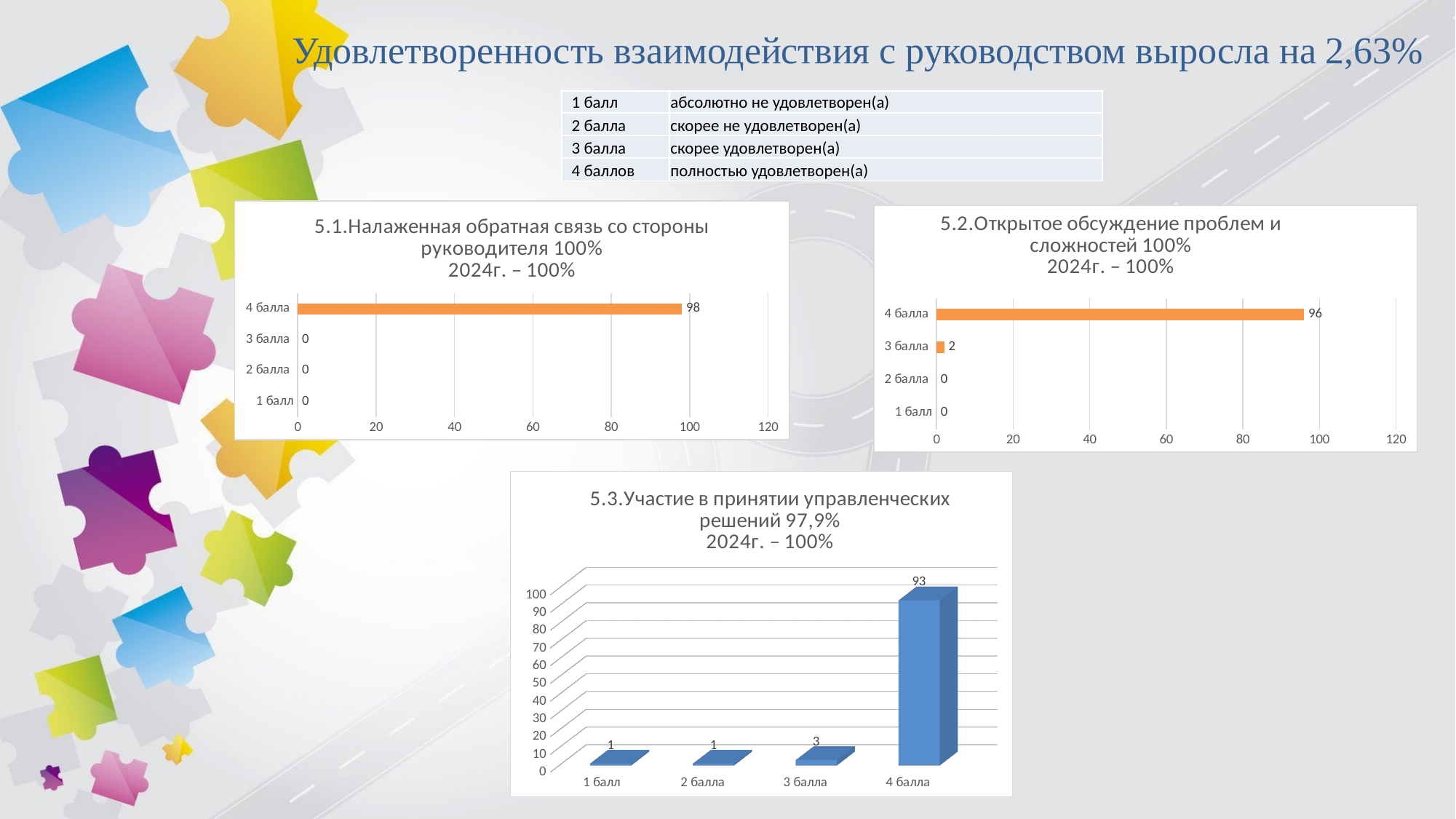
In the chart titled "5.3.Участие в принятии управленческих решений 97,9%", do the values rise or fall from 1 балл to 4 балла? rise Which chart has a value of 96 for 4 балла: the chart on the left, the chart on the right, or the chart at the bottom? The chart on the right (5.2.Открытое обсуждение проблем и сложностей 100%) In the chart titled "5.3.Участие в принятии управленческих решений 97,9%", what is the value for 3 балла? 3 In the chart titled "5.2.Открытое обсуждение проблем и сложностей 100%", what is the difference between the values for 4 балла and 3 балла? 94 In the chart titled "5.1.Налаженная обратная связь со стороны руководителя 100%", what kind of chart is shown? Bar chart In the chart titled "5.1.Налаженная обратная связь со стороны руководителя 100%", how many categories are plotted? 4 In the chart titled "5.2.Открытое обсуждение проблем и сложностей 100%", is the value for 4 балла greater or less than 80? greater In the chart titled "5.2.Открытое обсуждение проблем и сложностей 100%", what is the value for 3 балла? 2 In the chart titled "5.2.Открытое обсуждение проблем и сложностей 100%", which category has the highest value? 4 балла In the chart titled "5.3.Участие в принятии управленческих решений 97,9%", what is the value for 4 балла? 93 In the chart titled "5.3.Участие в принятии управленческих решений 97,9%", which is larger, the value for 3 балла or the value for 2 балла? 3 балла In the chart titled "5.1.Налаженная обратная связь со стороны руководителя 100%", what is the value for 4 балла? 98